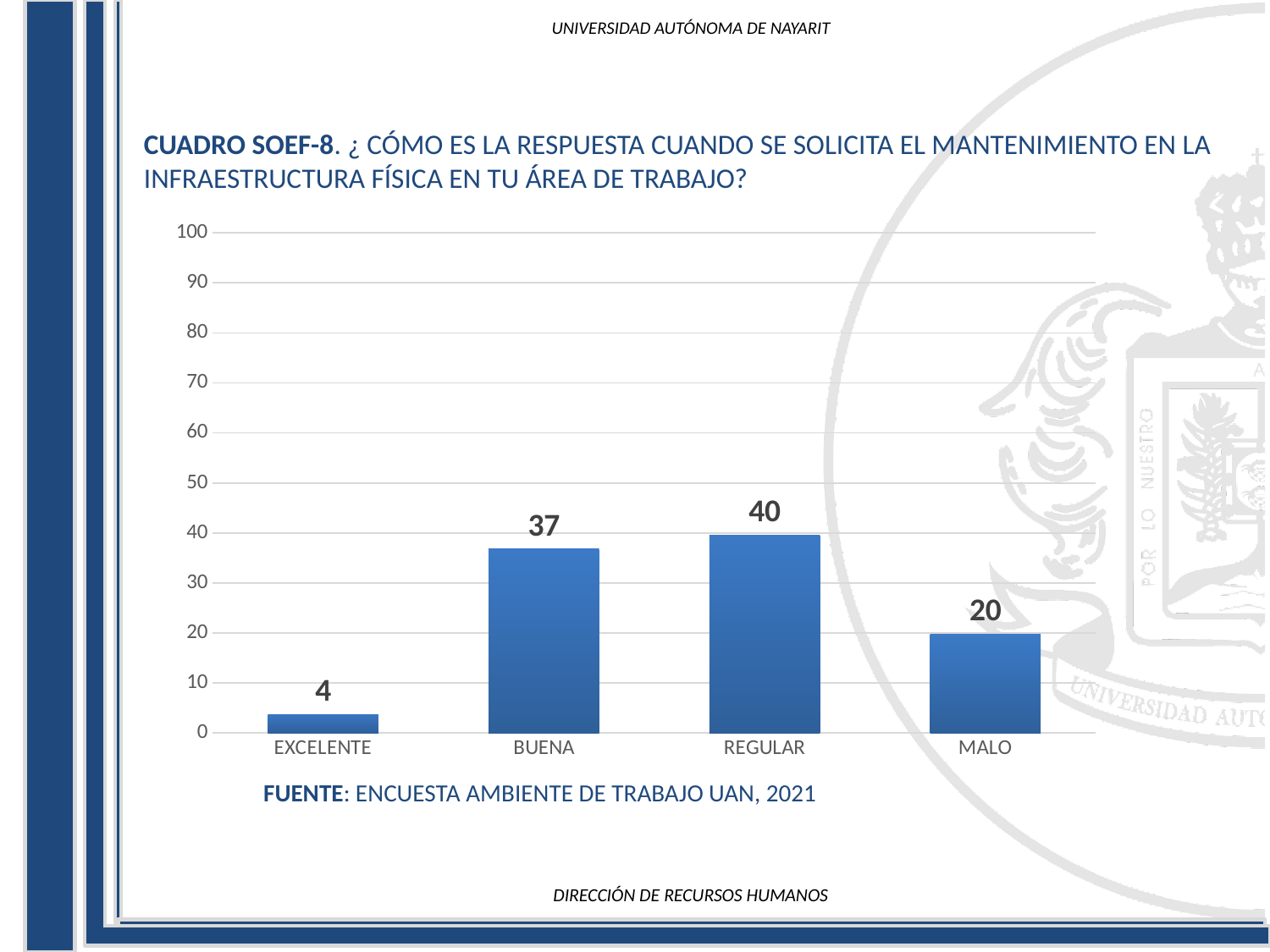
What kind of chart is shown on the slide? bar chart What is the difference between the values for REGULAR and MALO? 20 Is the value for REGULAR greater or less than 30? greater What is the value for MALO? 20 How many categories are shown on the x axis? 4 Which category has the lowest value? EXCELENTE Which is larger, the value for BUENA or the value for MALO? BUENA What source is cited below the chart? ENCUESTA AMBIENTE DE TRABAJO UAN, 2021 Which category has the highest value? REGULAR What is the value for BUENA? 37 What is the value for EXCELENTE? 4 What is the difference between the values for BUENA and EXCELENTE? 33